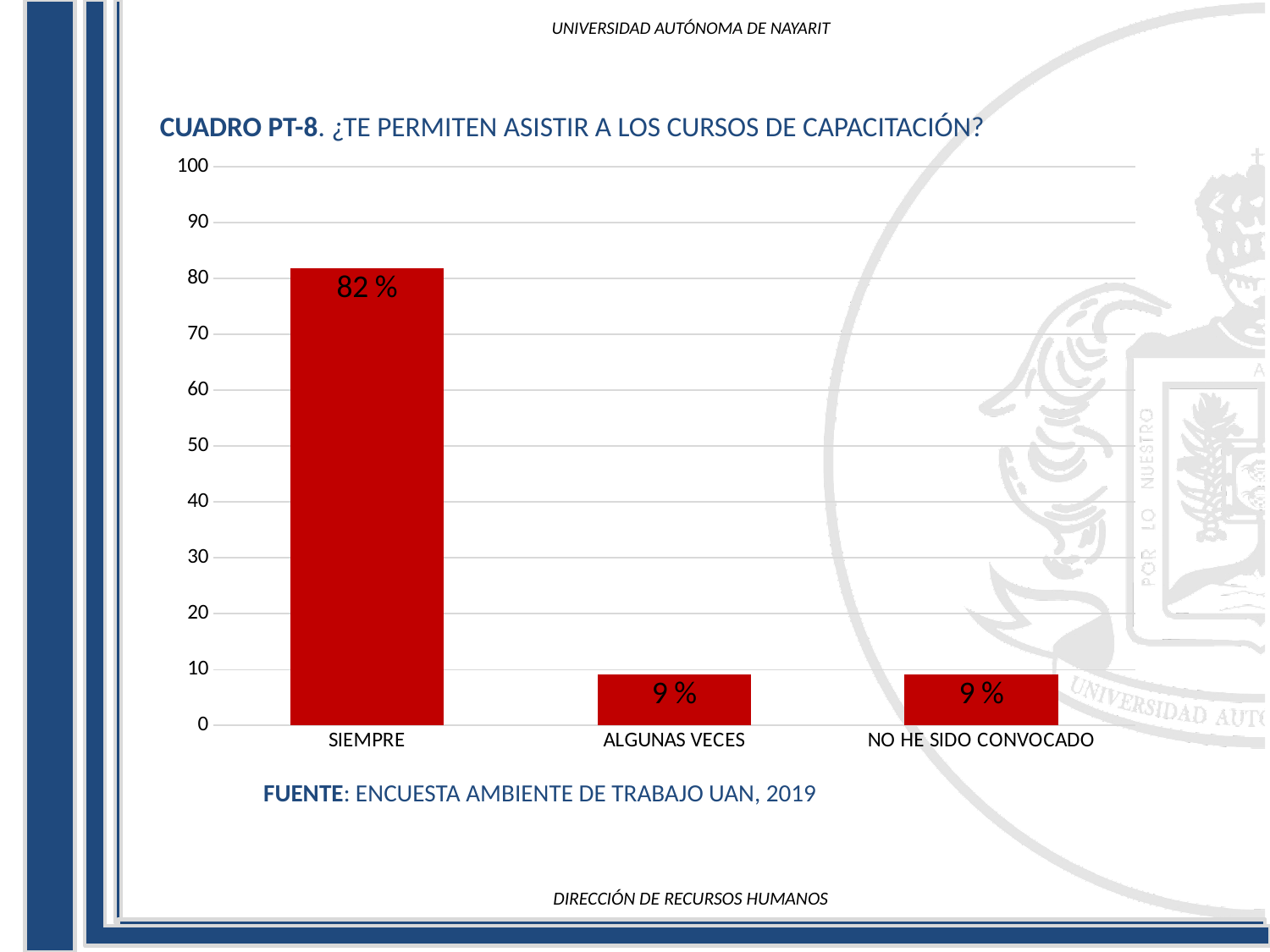
What is the value for SIEMPRE? 82 % What kind of chart is shown on the slide? bar chart What is the difference between the values for SIEMPRE and ALGUNAS VECES? 73 % Which is larger, the value for SIEMPRE or the value for NO HE SIDO CONVOCADO? SIEMPRE Which category has the highest value? SIEMPRE Is the value for ALGUNAS VECES greater or less than 20? less How many categories are shown on the x axis? 3 Is the value for SIEMPRE greater or less than 50? greater What is the value for NO HE SIDO CONVOCADO? 9 % What is the source cited below the chart? ENCUESTA AMBIENTE DE TRABAJO UAN, 2019 What is the value for ALGUNAS VECES? 9 % What is the title of the chart? CUADRO PT-8. ¿TE PERMITEN ASISTIR A LOS CURSOS DE CAPACITACIÓN?